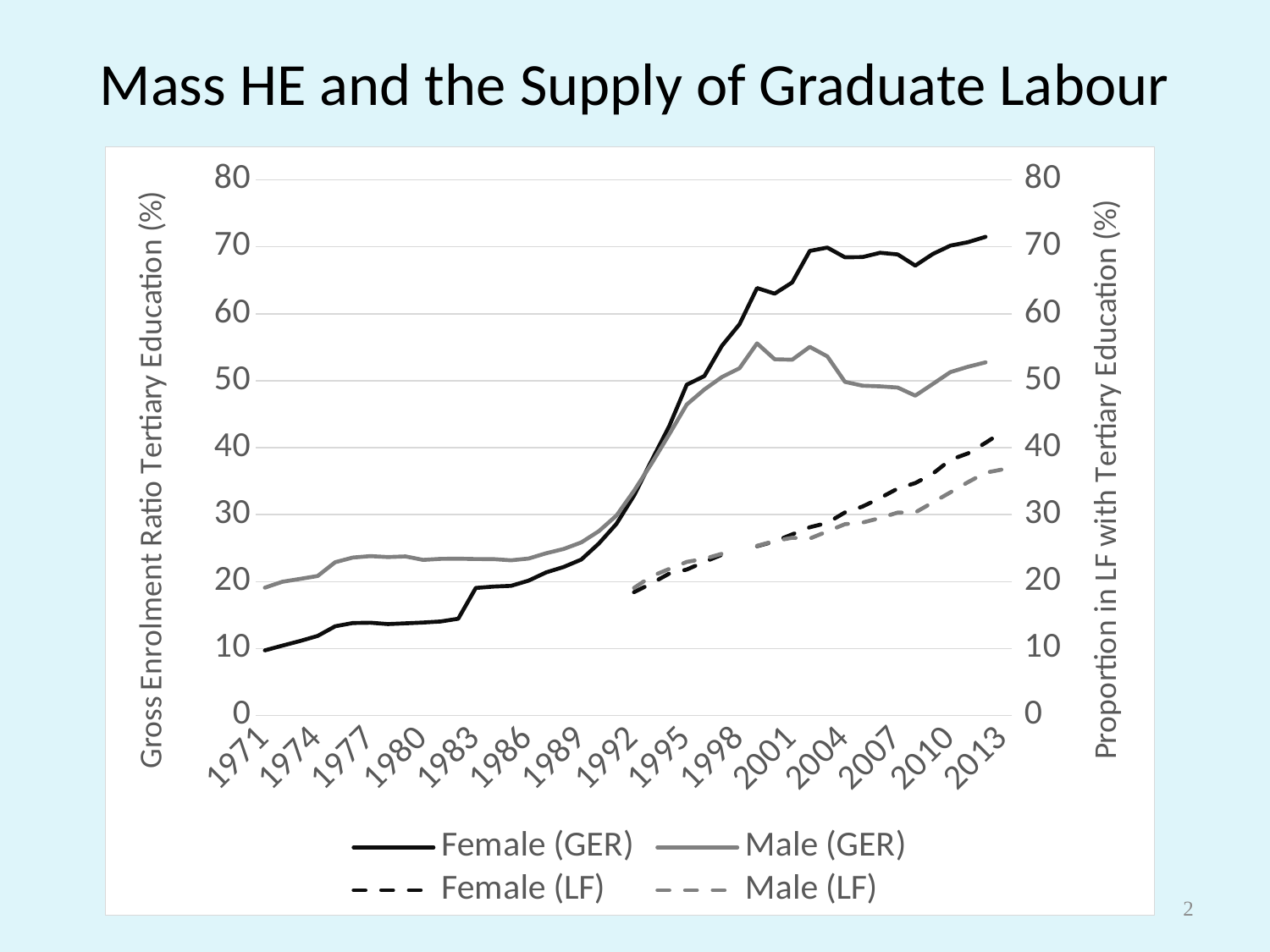
Is the value for Female (GER) in 1971 greater or less than 20? less What kind of chart is shown on the slide? line chart In 2013, which is higher: Female (LF) or Male (LF)? Female (LF) Is the value for Male (LF) in 2013 greater or less than 40? less Overall, does the Female (GER) line rise or fall from 1971 to 2013? rise In 1971, which is higher: Female (GER) or Male (GER)? Male (GER) How many series does the chart's legend list? 4 Is the value for Female (LF) in 2013 greater or less than 30? greater What is the title of the right-hand vertical axis? Proportion in LF with Tertiary Education (%)